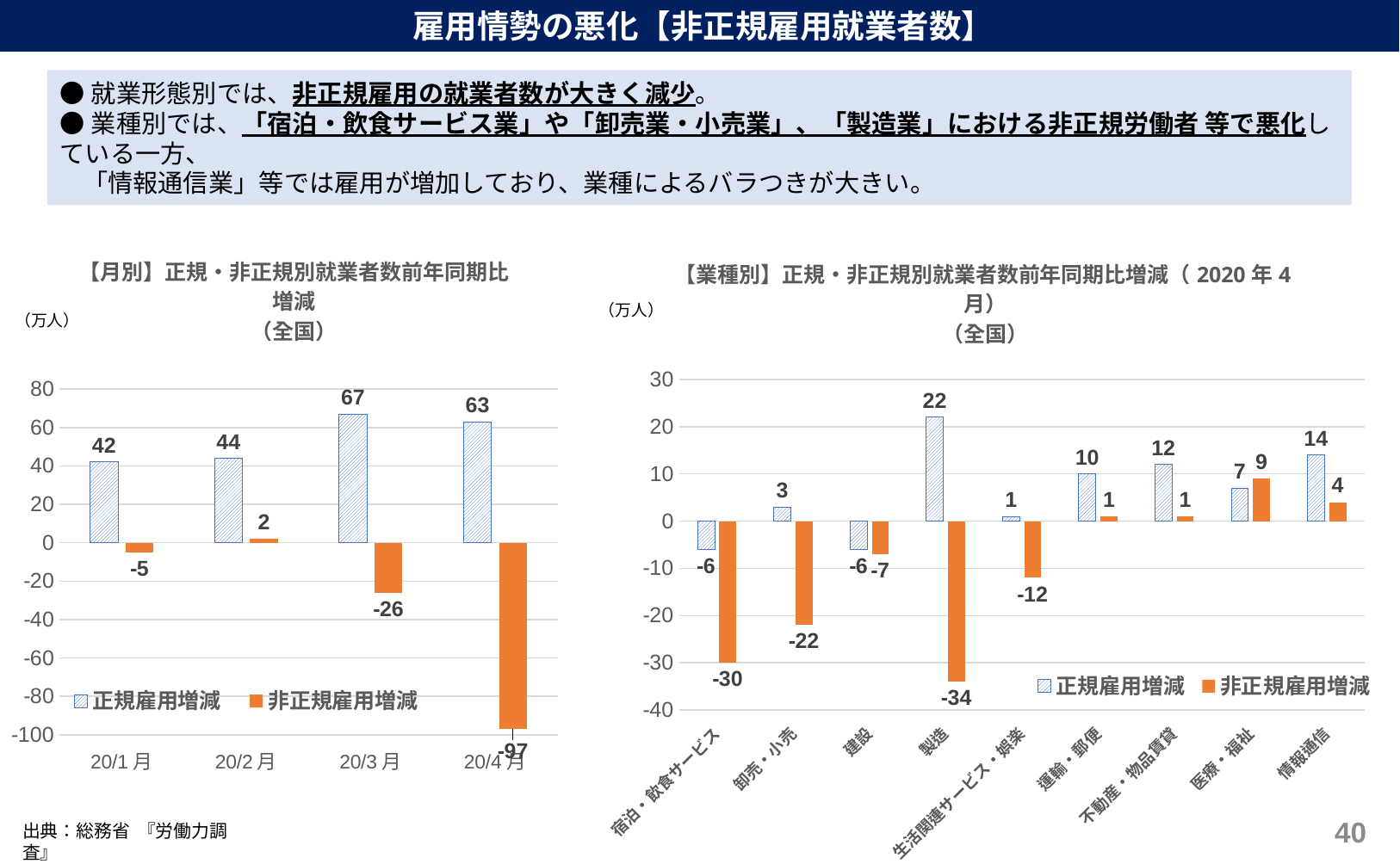
In the left chart (【月別】), how many months are shown on the x axis? 4 In the right chart (【業種別】), what is the value of 非正規雇用増減 for 製造? -34 In the right chart (【業種別】), which industry has the lowest 非正規雇用増減 value? 製造 In the right chart (【業種別】), which industry has the highest 正規雇用増減 value? 製造 In the right chart (【業種別】), which is larger for 医療・福祉: 正規雇用増減 or 非正規雇用増減? 非正規雇用増減 In the left chart (【月別】), what is the value of 正規雇用増減 for 20/3月? 67 In the left chart (【月別】), does the 非正規雇用増減 series rise or fall from 20/2月 to 20/4月? fall In the left chart (【月別】), what is the value of 非正規雇用増減 for 20/4月? -97 In the right chart (【業種別】), how many industries are shown on the x axis? 9 In the left chart (【月別】), what is the difference between the 正規雇用増減 values for 20/2月 and 20/1月? 2 In the left chart (【月別】), which month has the highest 正規雇用増減 value? 20/3月 What type of chart is the right chart (【業種別】)? bar chart